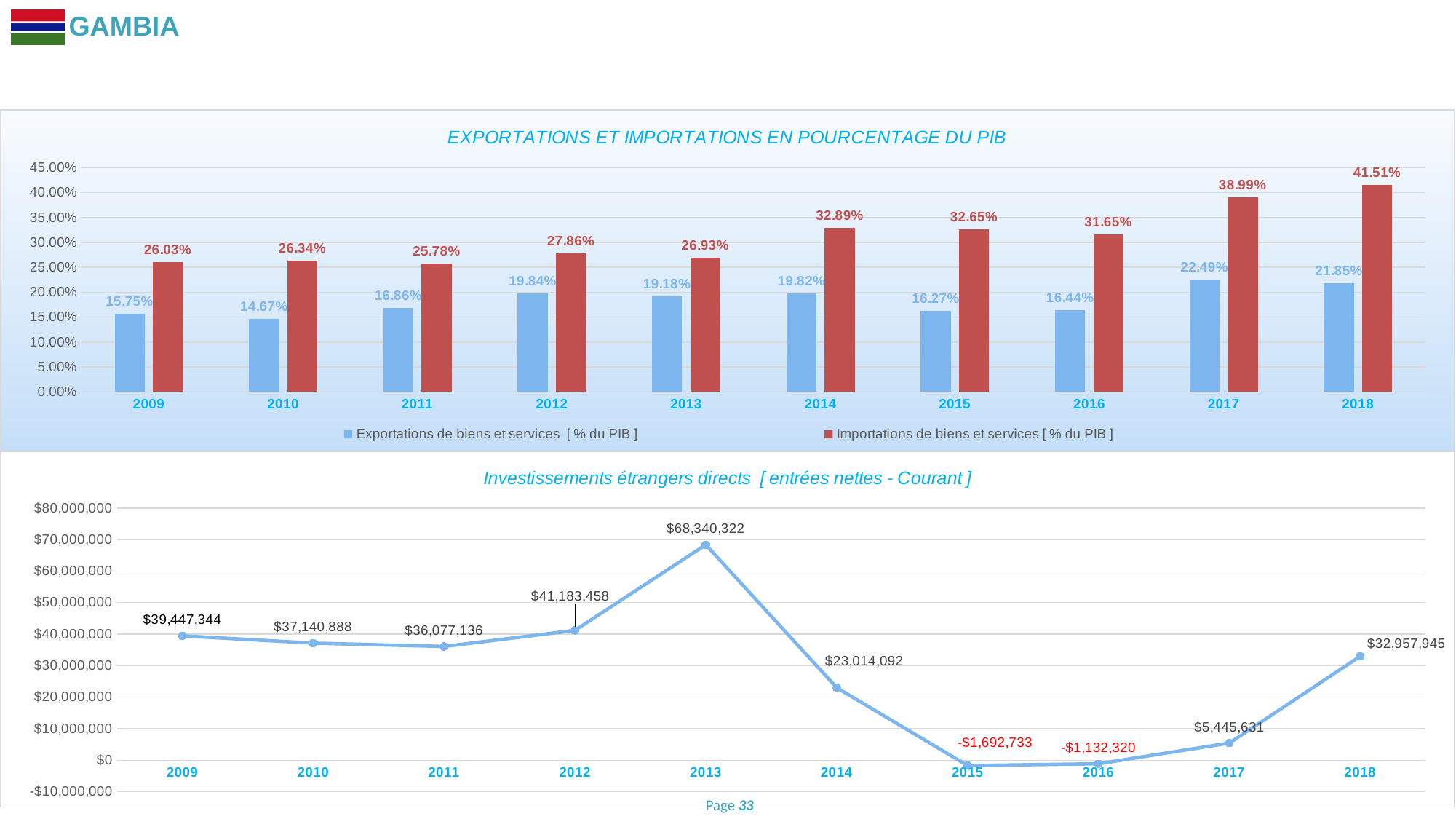
In the chart 'Investissements étrangers directs', what is the difference between the values for 2013 and 2014? $45,326,230 What kind of chart is 'EXPORTATIONS ET IMPORTATIONS EN POURCENTAGE DU PIB'? Bar chart In the chart 'Investissements étrangers directs', which year has the lowest value? 2015 In the chart 'Investissements étrangers directs', how many years are plotted? 10 In the chart 'EXPORTATIONS ET IMPORTATIONS EN POURCENTAGE DU PIB', what is the difference between Importations and Exportations in 2018? 19.66% In the chart 'EXPORTATIONS ET IMPORTATIONS EN POURCENTAGE DU PIB', what is the value of Exportations de biens et services for 2012? 19.84% In the chart 'Investissements étrangers directs', what is the value for 2013? $68,340,322 In the chart 'EXPORTATIONS ET IMPORTATIONS EN POURCENTAGE DU PIB', which year has the highest value for Importations de biens et services? 2018 In the chart 'EXPORTATIONS ET IMPORTATIONS EN POURCENTAGE DU PIB', which year has the lowest value for Exportations de biens et services? 2010 In the chart 'EXPORTATIONS ET IMPORTATIONS EN POURCENTAGE DU PIB', how many series does the legend list? 2 In the chart 'Investissements étrangers directs', what is the value for 2016? -$1,132,320 In the chart 'EXPORTATIONS ET IMPORTATIONS EN POURCENTAGE DU PIB', what is the value of Importations de biens et services for 2015? 32.65%